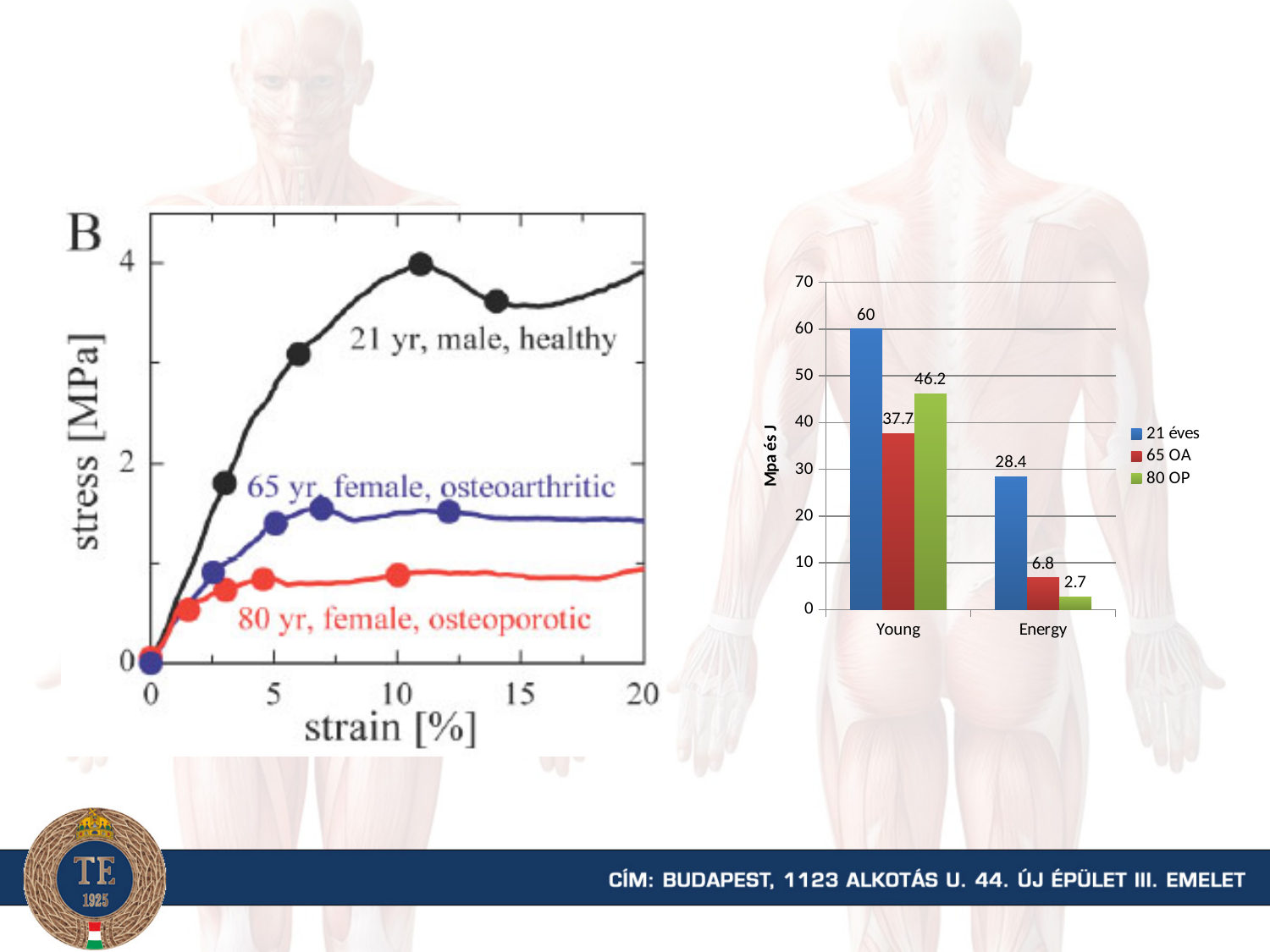
In the bar chart on the right, which series has the highest value in the Young category? 21 éves In the bar chart on the right, what is the value for 65 OA in the Young category? 37.7 How many categories are shown on the x axis of the bar chart on the right? 2 In the bar chart on the right, which series has the lowest value in the Energy category? 80 OP In the bar chart on the right, which is larger in the Young category: 65 OA or 80 OP? 80 OP What kind of chart is the chart on the left labelled B? line chart What is the y-axis label of the bar chart on the right? Mpa és J How many series does the legend of the bar chart on the right list? 3 In the bar chart on the right, what is the value for 21 éves in the Young category? 60 In the line chart on the left, is the peak stress of the 21 yr, male, healthy curve greater or less than 2 MPa? greater In the bar chart on the right, what is the difference between the 21 éves and 65 OA values in the Energy category? 21.6 In the bar chart on the right, what is the value for 80 OP in the Energy category? 2.7